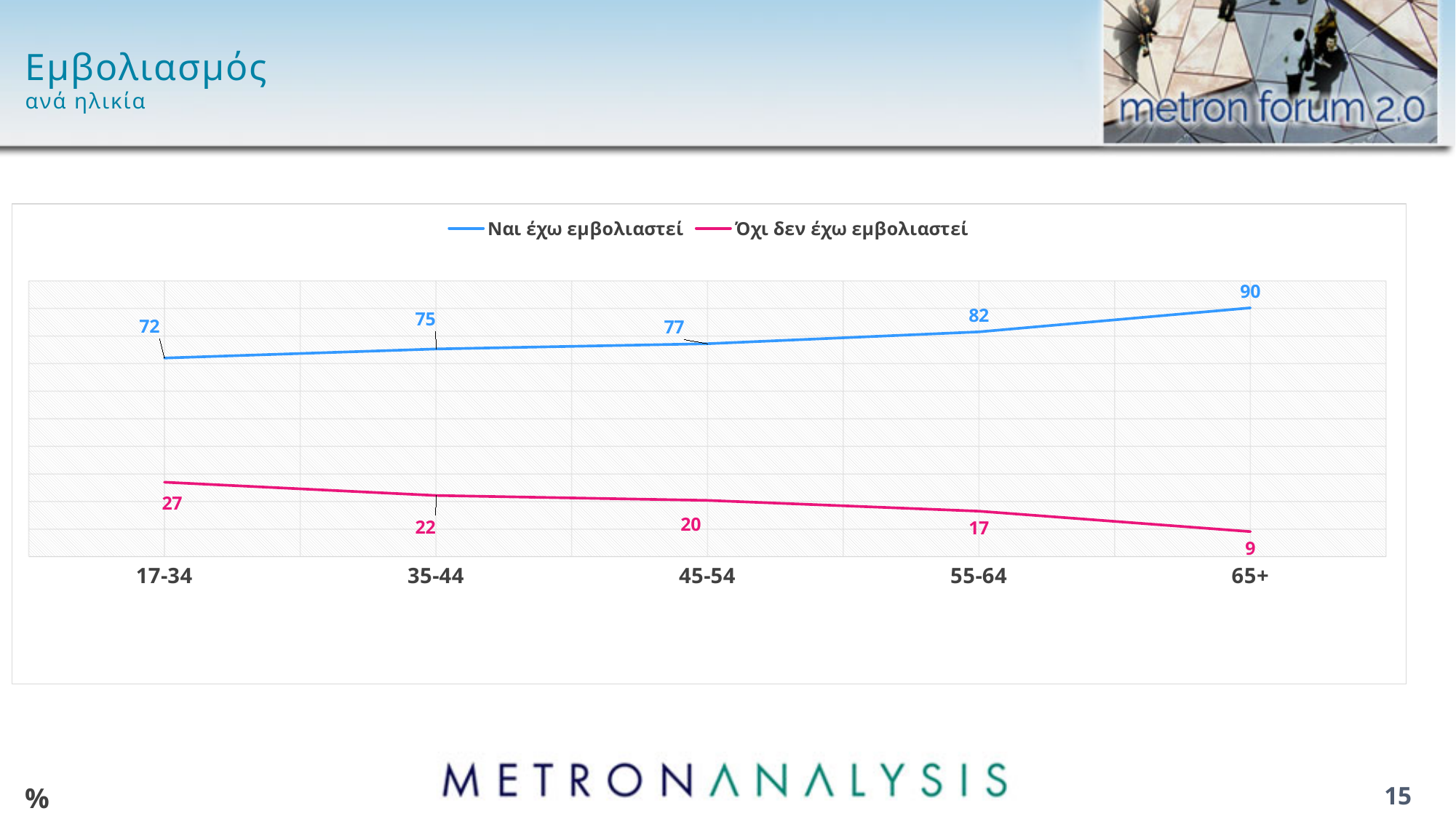
What colour is the line for 'Όχι δεν έχω εμβολιαστεί'? Pink Which is larger: the 'Όχι δεν έχω εμβολιαστεί' value for 35-44 or for 55-64? 35-44 Does the 'Ναι έχω εμβολιαστεί' line rise or fall from 17-34 to 65+? Rises What kind of chart is shown on the slide? Line chart How many age groups are shown on the x axis? 5 How many series does the legend list? 2 What is the difference between the 'Ναι έχω εμβολιαστεί' values for 65+ and 17-34? 18 Which age group has the lowest value for 'Όχι δεν έχω εμβολιαστεί'? 65+ What is the value for 'Ναι έχω εμβολιαστεί' in the 45-54 age group? 77 What is the value for 'Ναι έχω εμβολιαστεί' in the 65+ age group? 90 Which age group has the highest value for 'Ναι έχω εμβολιαστεί'? 65+ What is the value for 'Όχι δεν έχω εμβολιαστεί' in the 17-34 age group? 27